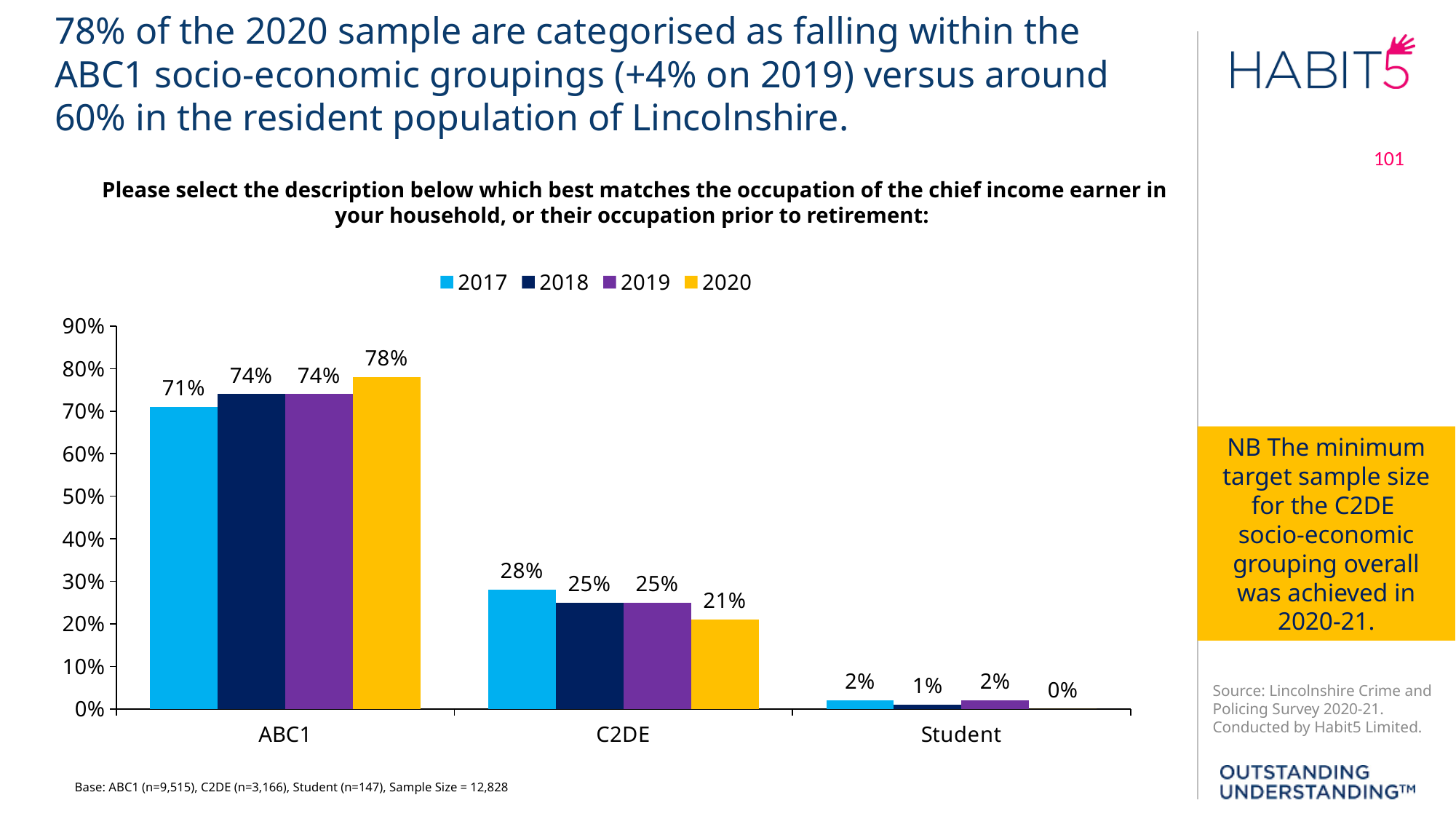
Which category has the lowest value in 2019? Student What is the difference between the ABC1 values for 2020 and 2017? 7% What is the difference between the C2DE values for 2017 and 2020? 7% What is the value for Student in 2018? 1% What percentage of the 2020 sample falls within the ABC1 grouping? 78% What is the value for C2DE in 2017? 28% How many categories are shown on the x axis? 3 What kind of chart is shown on the slide? Bar chart Which is larger, the C2DE value for 2017 or for 2020? 2017 Which colour represents the 2020 series in the chart? Yellow How many series does the legend list? 4 Which category has the highest value in 2020? ABC1